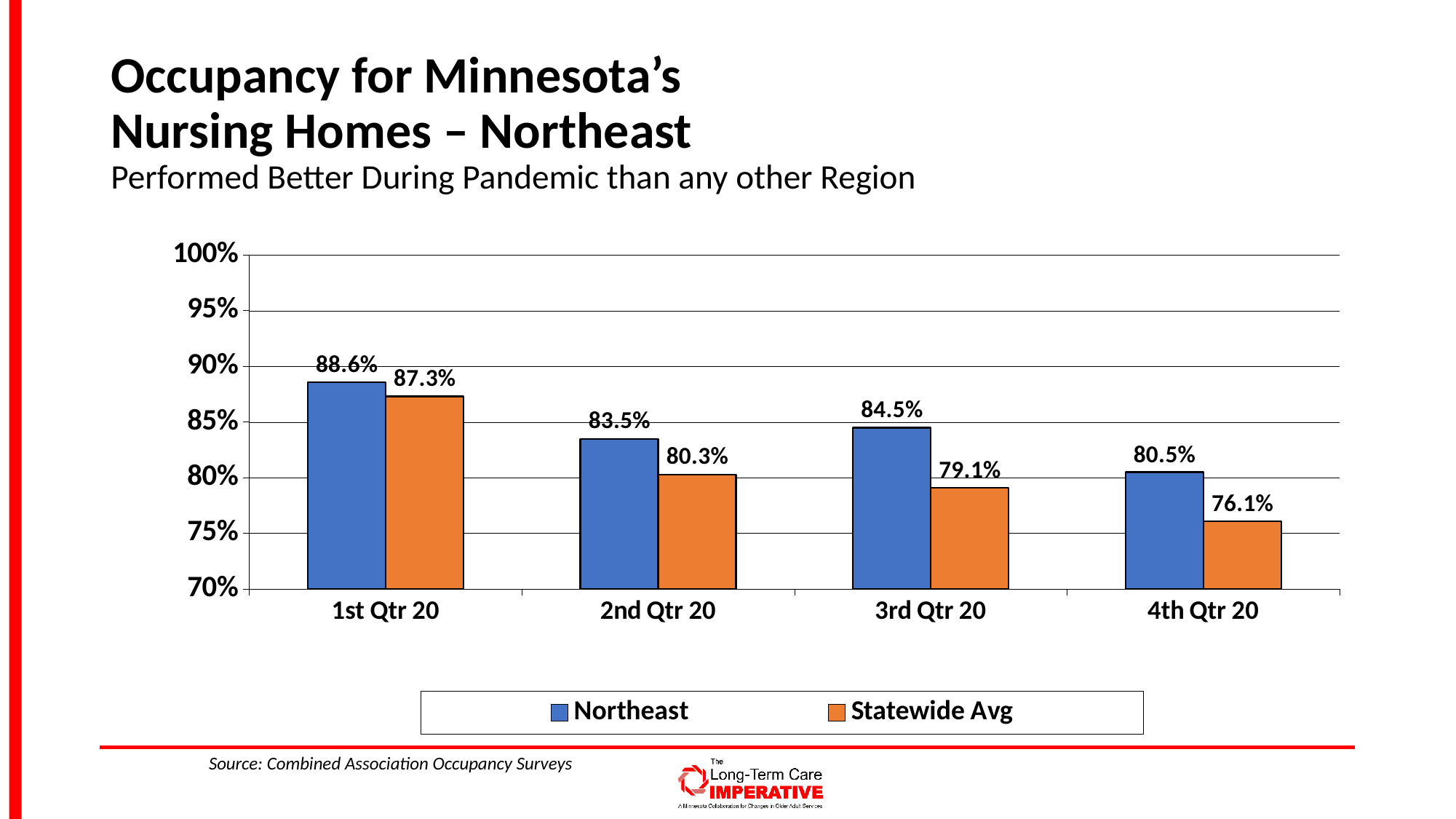
How many quarters are shown on the x axis? 4 In which quarter is the Northeast occupancy highest? 1st Qtr 20 What is the Northeast occupancy value for 1st Qtr 20? 88.6% Does the Statewide Avg occupancy rise or fall from 1st Qtr 20 to 4th Qtr 20? Fall Which is larger in 4th Qtr 20, the Northeast value or the Statewide Avg value? Northeast How many series does the legend list? 2 In which quarter is the Statewide Avg occupancy lowest? 4th Qtr 20 What is the difference between the Northeast and Statewide Avg values in 3rd Qtr 20? 5.4% Is the Northeast value for 2nd Qtr 20 greater or less than 85%? less What kind of chart is shown on the slide? Bar chart What is the Statewide Avg value for 2nd Qtr 20? 80.3% What is the Statewide Avg occupancy value for 4th Qtr 20? 76.1%